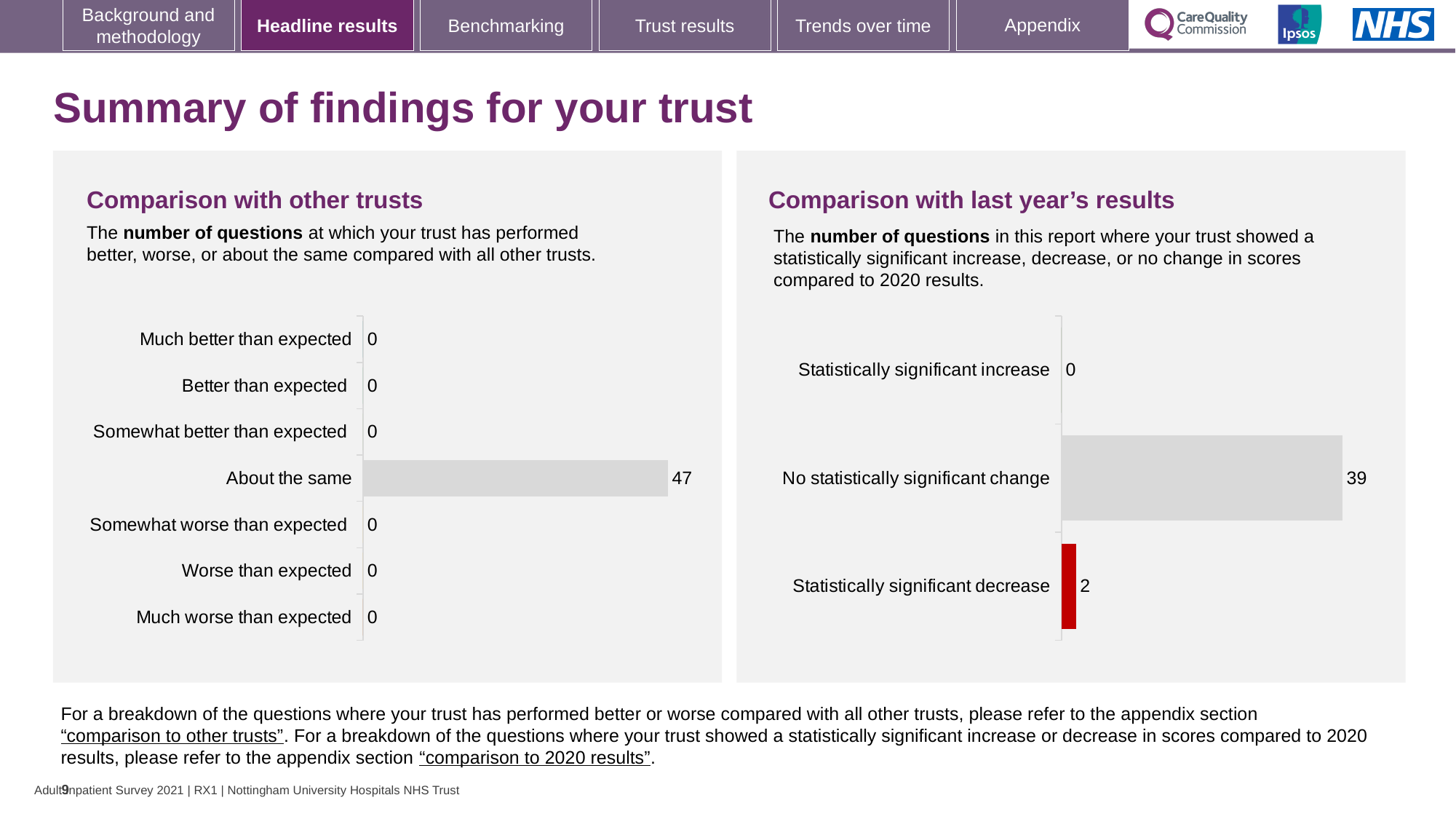
In the 'Comparison with last year's results' chart, what is the value for 'Statistically significant increase'? 0 In the 'Comparison with other trusts' chart, what is the value for 'About the same'? 47 How many categories are shown in the 'Comparison with last year's results' chart? 3 In the 'Comparison with last year's results' chart, what is the difference between 'No statistically significant change' and 'Statistically significant decrease'? 37 In the 'Comparison with other trusts' chart, what is the value for 'Somewhat worse than expected'? 0 In the 'Comparison with other trusts' chart, which category has the highest value? About the same In the 'Comparison with last year's results' chart, which is larger: 'Statistically significant increase' or 'Statistically significant decrease'? Statistically significant decrease In the 'Comparison with last year's results' chart, what is the value for 'No statistically significant change'? 39 In the 'Comparison with last year's results' chart, which bar is coloured red? Statistically significant decrease What kind of chart is the 'Comparison with other trusts' chart? Bar chart How many categories are shown in the 'Comparison with other trusts' chart? 7 In the 'Comparison with last year's results' chart, what is the value for 'Statistically significant decrease'? 2